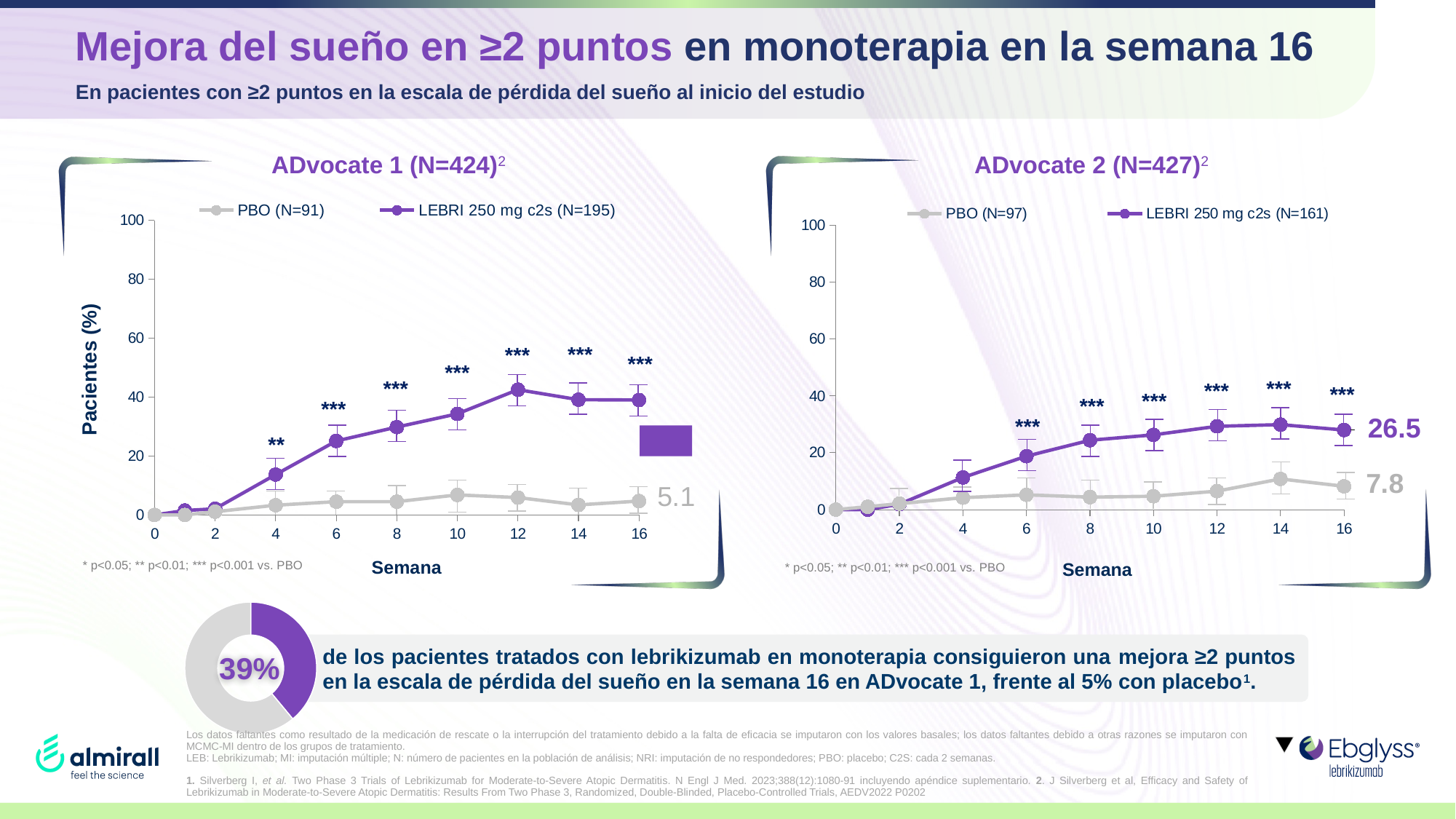
In the ADvocate 2 (N=427) chart, what is the value for PBO at week 16? 7.8 In the ADvocate 1 (N=424) chart, what is the value for PBO at week 16? 5.1 In the ADvocate 1 (N=424) chart, at which week does the LEBRI 250 mg c2s series reach its highest value? Week 12 In the ADvocate 2 (N=427) chart, what is the difference between LEBRI 250 mg c2s and PBO at week 16? 18.7 How many series does the legend of the ADvocate 2 (N=427) chart list? 2 What kind of chart is the ADvocate 1 (N=424) chart? Line chart In the ADvocate 1 (N=424) chart, is the value for LEBRI 250 mg c2s at week 4 greater or less than 20? less In the ADvocate 1 (N=424) chart, is the value for LEBRI 250 mg c2s at week 16 greater or less than 20? greater In the ADvocate 1 (N=424) chart, does the LEBRI 250 mg c2s series rise or fall from week 0 to week 12? Rise In the ADvocate 2 (N=427) chart, which series has the higher value at week 16, PBO or LEBRI 250 mg c2s? LEBRI 250 mg c2s What share does the purple slice of the donut chart at the bottom of the slide represent? 39% In the ADvocate 2 (N=427) chart, what is the value for LEBRI 250 mg c2s at week 16? 26.5